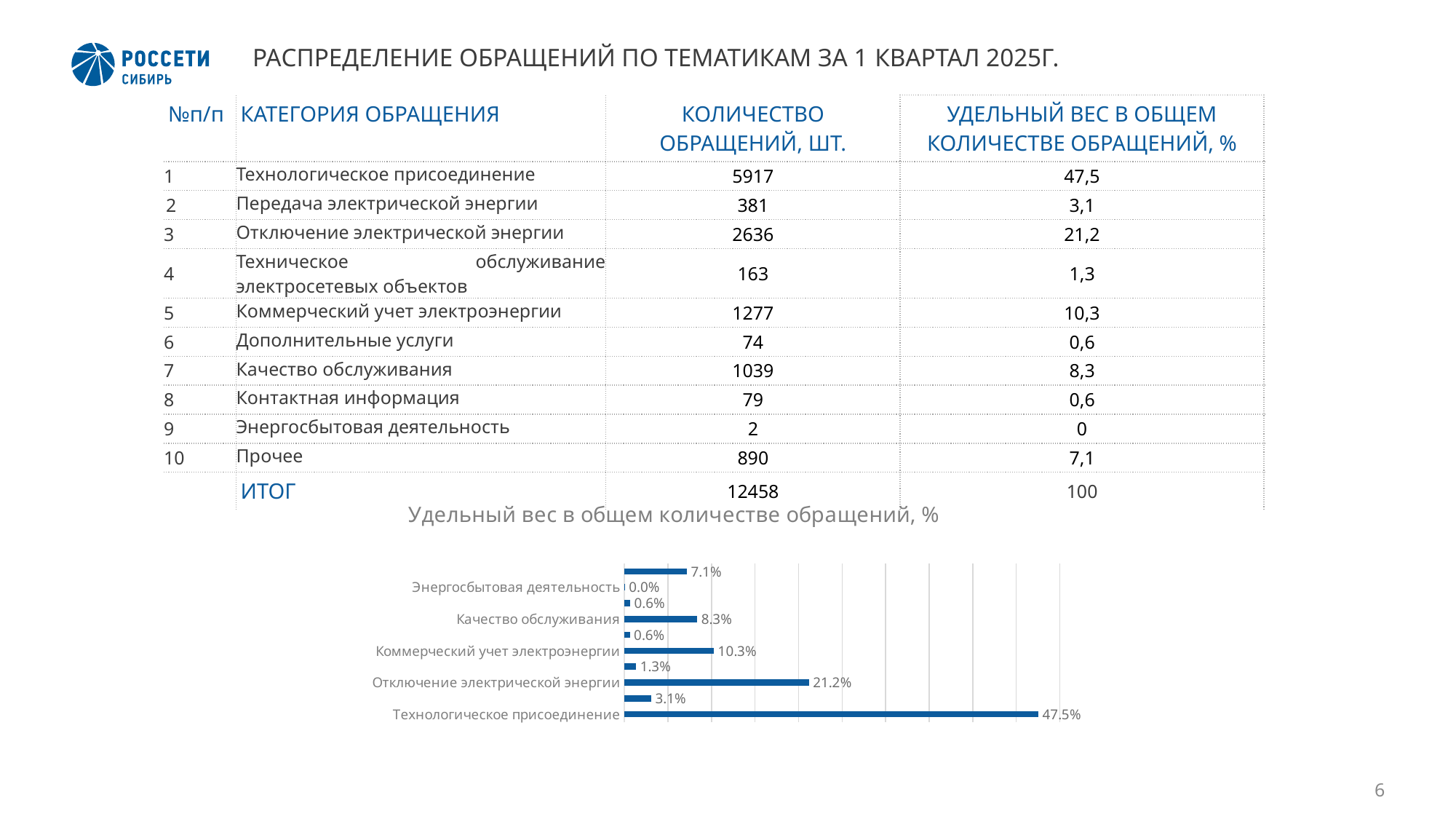
Which category has the lowest value in the chart? Энергосбытовая деятельность How many bars are plotted in the chart? 10 Which is larger: the value for Качество обслуживания or the value for Коммерческий учет электроэнергии? Коммерческий учет электроэнергии What is the value for Отключение электрической энергии in the chart? 21.2% What is the value for Энергосбытовая деятельность in the chart? 0.0% What is the title of the chart? Удельный вес в общем количестве обращений, % What type of chart is shown on the slide? Bar chart What is the value for Коммерческий учет электроэнергии in the chart? 10.3% What is the value for Технологическое присоединение in the chart? 47.5% Which category has the highest value in the chart? Технологическое присоединение What is the value for Качество обслуживания in the chart? 8.3% What is the difference between the values for Технологическое присоединение and Отключение электрической энергии? 26.3%